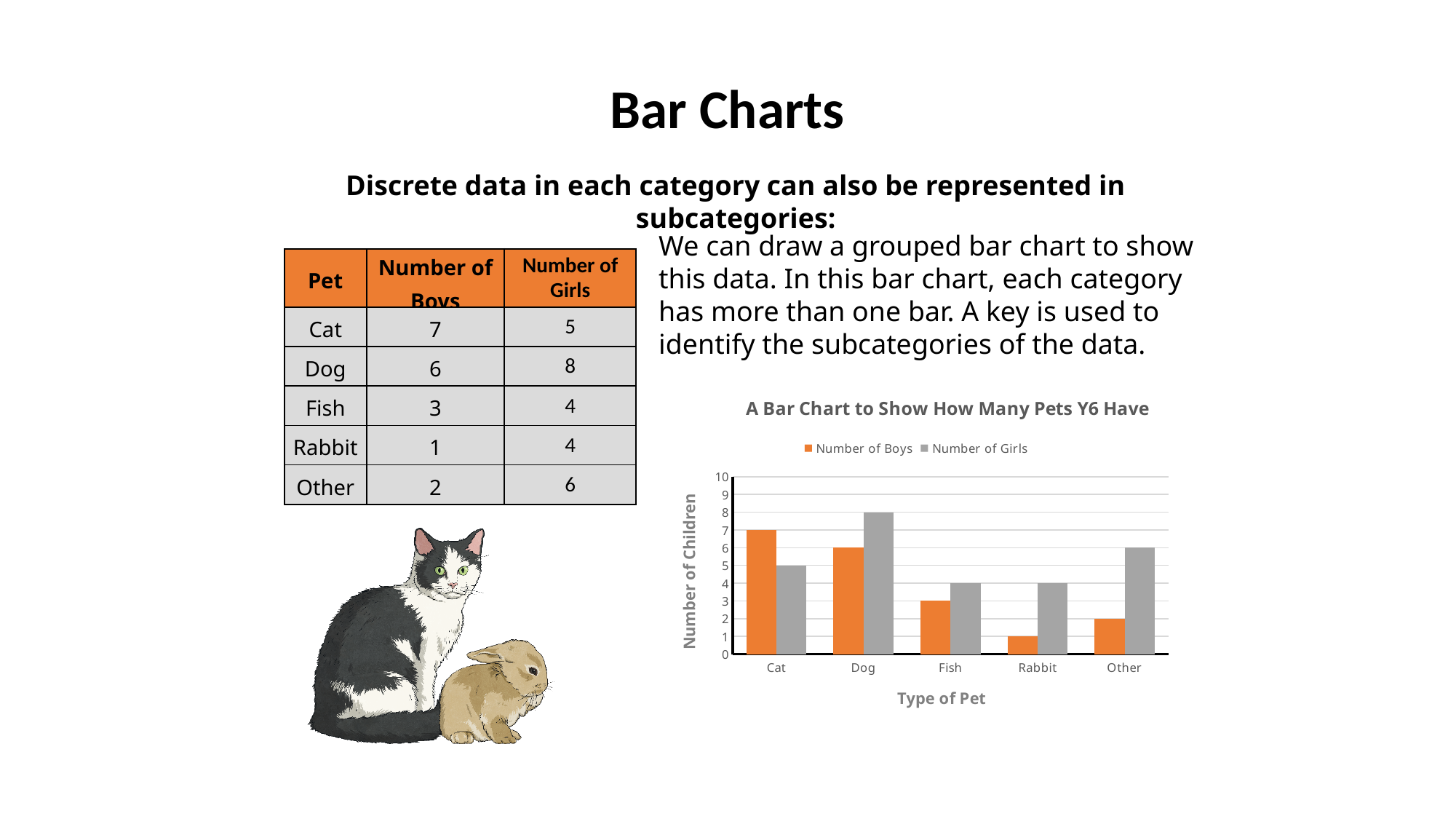
What is the Number of Girls value for Dog in the bar chart? 8 Which type of pet has the highest Number of Girls in the bar chart? Dog For Cat, which is larger in the bar chart: Number of Boys or Number of Girls? Number of Boys How many types of pet are shown on the x axis of the bar chart? 5 Which type of pet has the lowest Number of Boys in the bar chart? Rabbit How many series does the legend of the bar chart list? 2 What is the difference between the Number of Girls and the Number of Boys for Other in the bar chart? 4 What is the Number of Boys value for Rabbit in the bar chart? 1 What is the Number of Boys value for Cat in the bar chart? 7 Is the Number of Girls value for Other greater or less than 5 in the bar chart? greater What is the title of the bar chart? A Bar Chart to Show How Many Pets Y6 Have What kind of chart is shown on the slide? bar chart